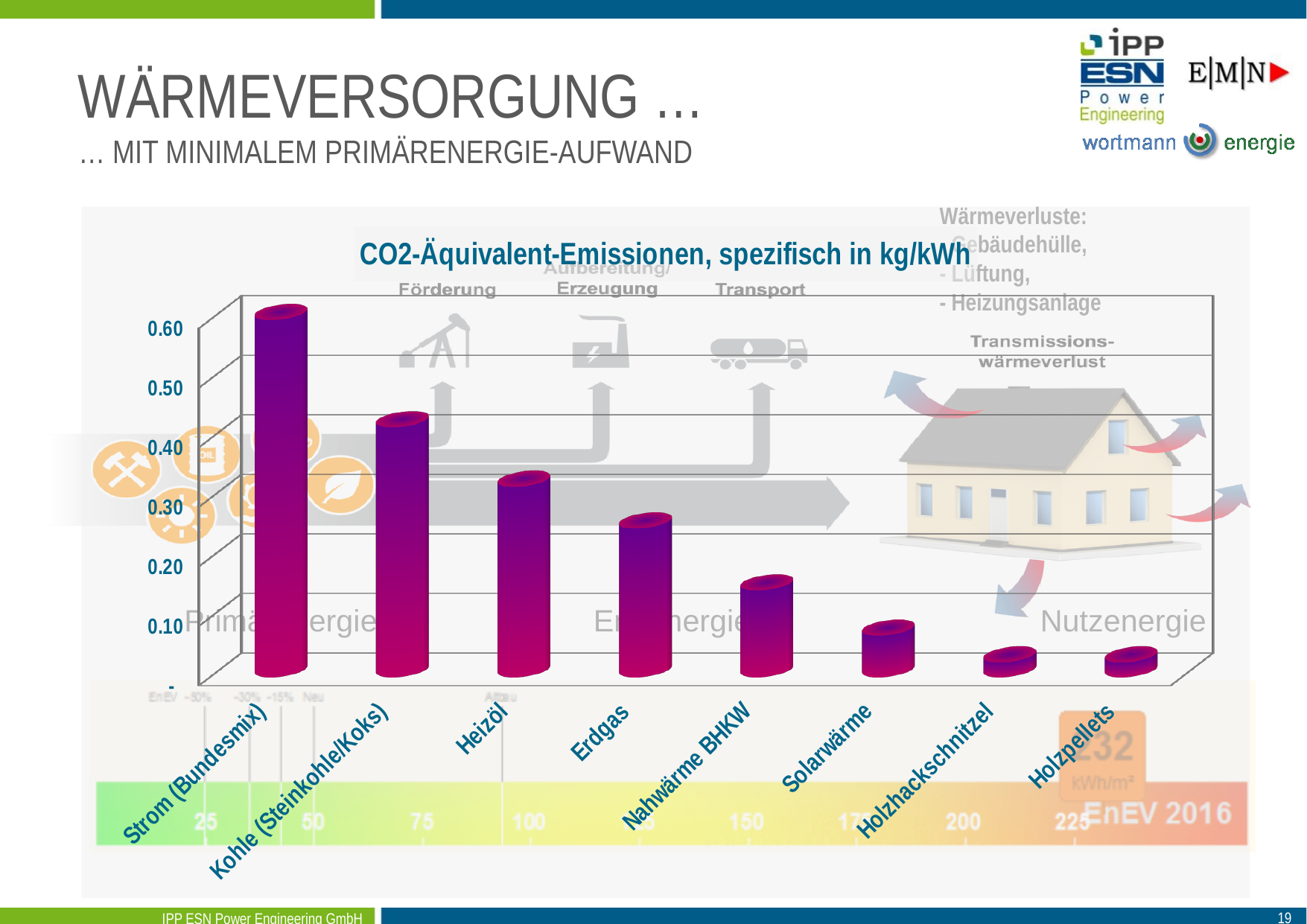
How many categories are plotted in the chart? 8 Is the value for Solarwärme greater or less than 0.10? less Is the value for Erdgas greater or less than 0.20? greater Is the value for Heizöl greater or less than 0.40? less Do the values rise or fall from left to right along the x axis? fall Which has higher emissions, Heizöl or Erdgas? Heizöl What kind of chart is shown on the slide? bar chart What is the title of the chart? CO2-Äquivalent-Emissionen, spezifisch in kg/kWh Which category has the highest CO2-equivalent emissions? Strom (Bundesmix)